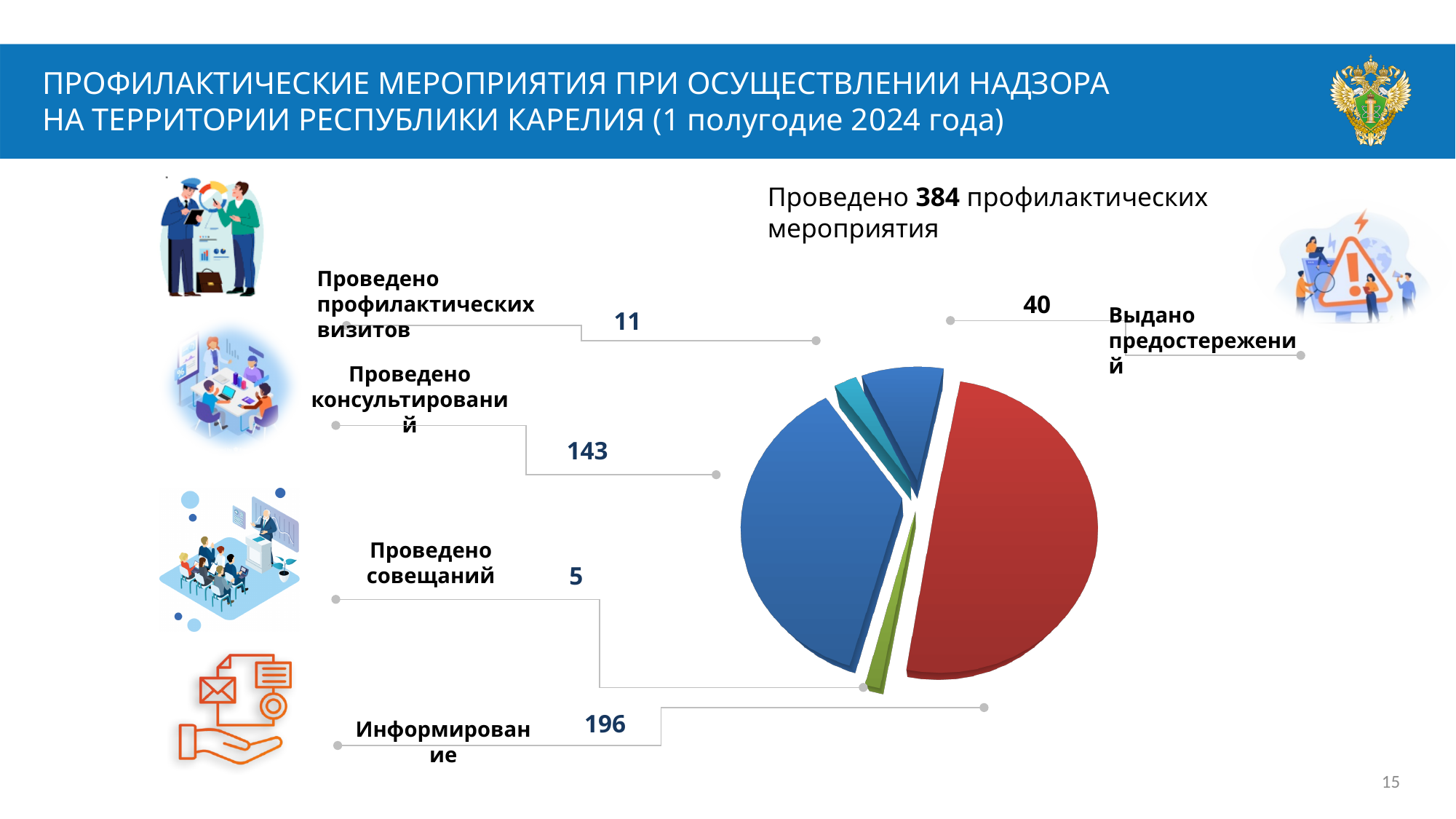
What is the value for Проведено совещаний? 5 What is the value for Информирование? 196 How many categories (slices) does the pie chart have? 5 Which category has the highest value? Информирование What is the difference between Информирование and Проведено консультирований? 53 What is the value for Выдано предостережений? 40 What is the value for Проведено консультирований? 143 What colour is the largest slice of the pie chart? red Which category has the lowest value? Проведено совещаний What is the value for Проведено профилактических визитов? 11 Which is larger: Выдано предостережений or Проведено профилактических визитов? Выдано предостережений What kind of chart is shown on the slide? pie chart